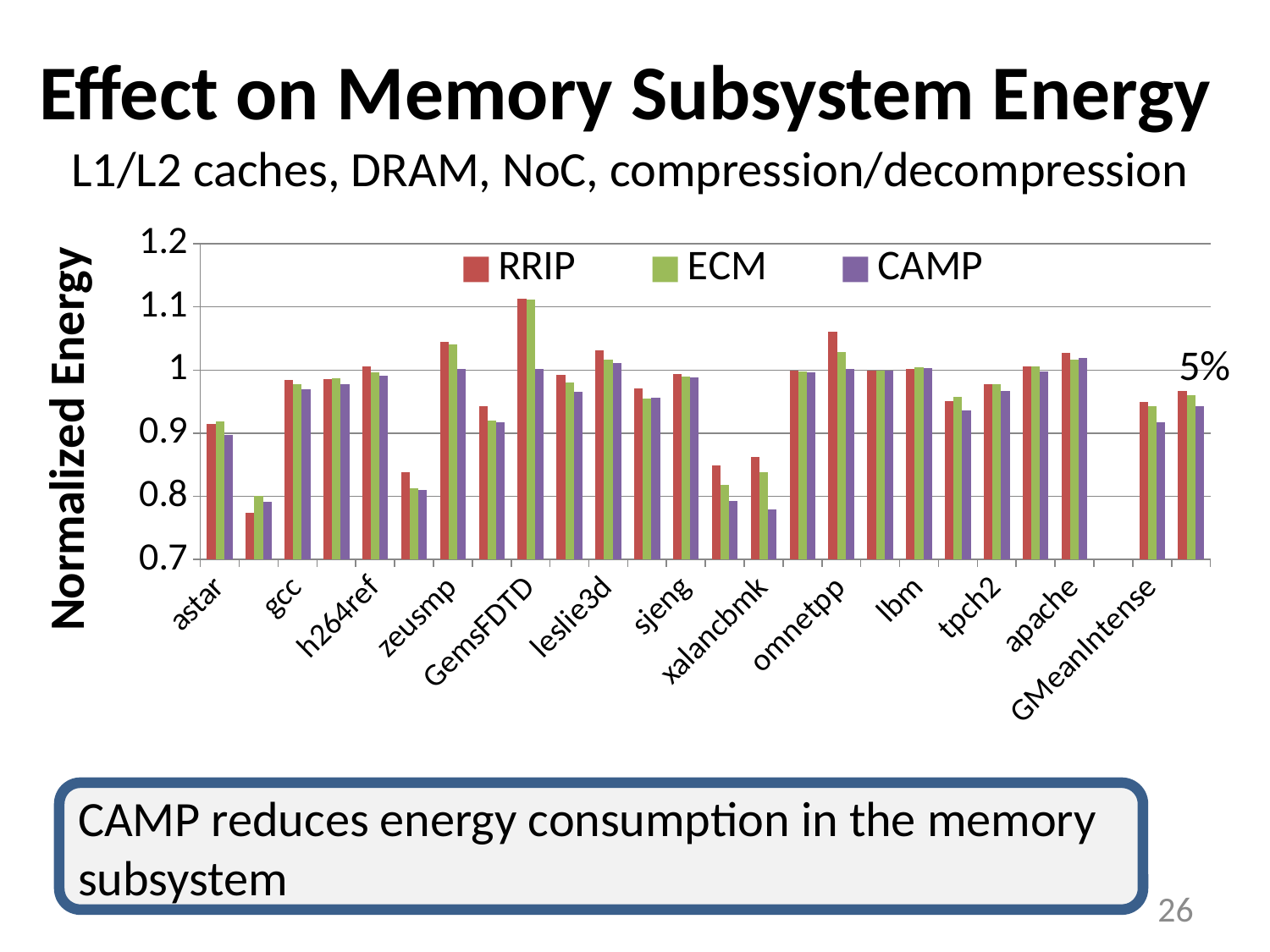
Is the CAMP value for zeusmp greater or less than 0.9? greater What is the title of the y axis? Normalized Energy Is the RRIP value for xalancbmk greater or less than 0.9? less What kind of chart is shown on the slide? bar chart How many series does the chart's legend list? 3 Is the RRIP value for GemsFDTD greater or less than 1? greater What are the three series named in the legend? RRIP, ECM, CAMP Which labeled benchmark has the highest RRIP value? GemsFDTD For omnetpp, which is larger: the RRIP value or the ECM value? RRIP For GMeanIntense, which is larger: the RRIP value or the CAMP value? RRIP